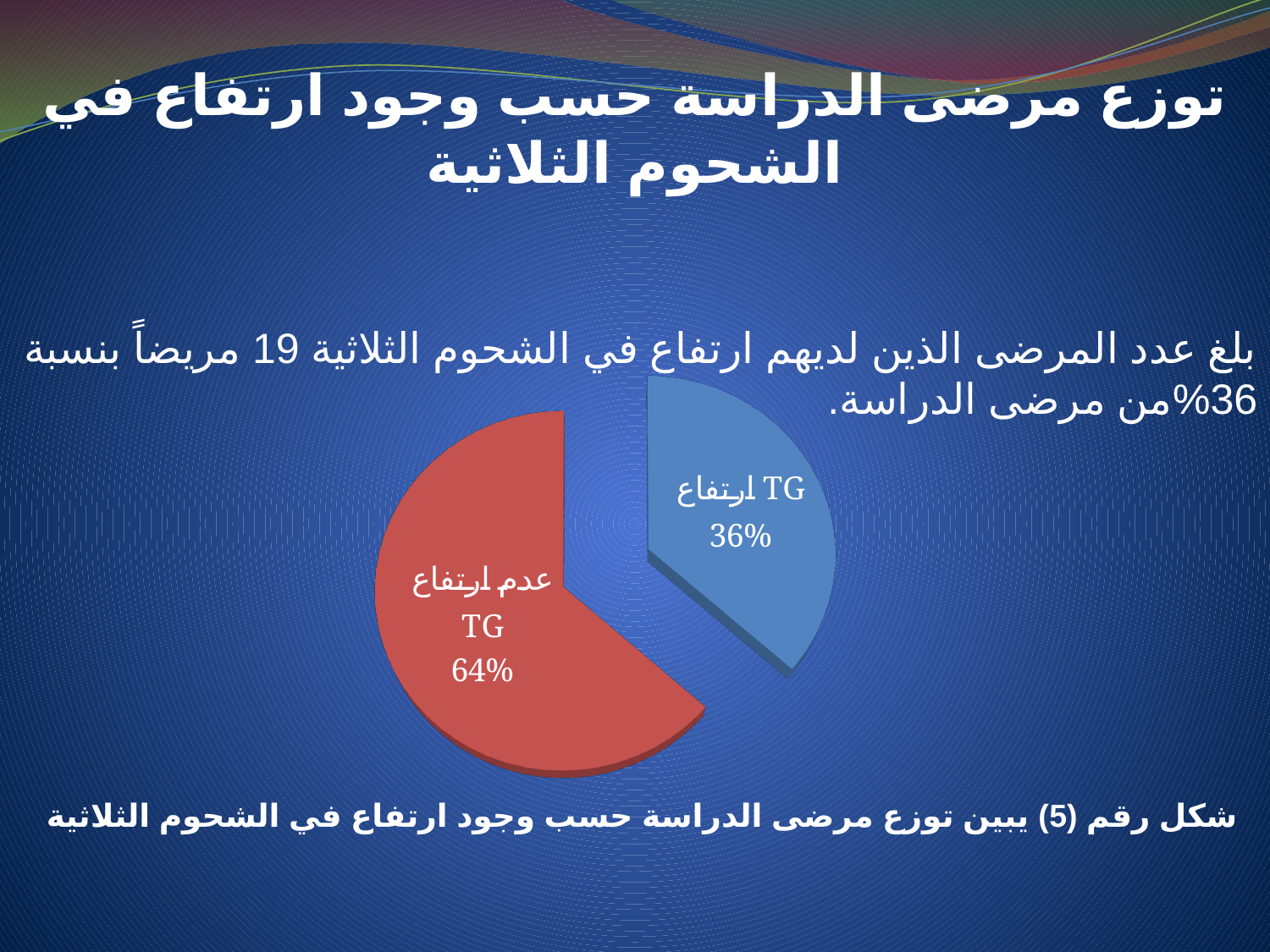
What percentage of the pie is labelled "عدم ارتفاع TG"? 64% What share of the pie does the "ارتفاع TG" slice represent? 36% Which slice of the pie chart is the largest? عدم ارتفاع TG Which slice of the pie chart is the smallest? ارتفاع TG Which is larger: the "ارتفاع TG" slice or the "عدم ارتفاع TG" slice? عدم ارتفاع TG What colour is the "ارتفاع TG" slice in the pie chart? Blue What percentage of the pie is labelled "ارتفاع TG"? 36% What kind of chart is shown on the slide? Pie chart How many slices does the pie chart have? 2 What colour is the "عدم ارتفاع TG" slice in the pie chart? Red What is the difference in percentage points between the "عدم ارتفاع TG" slice and the "ارتفاع TG" slice? 28